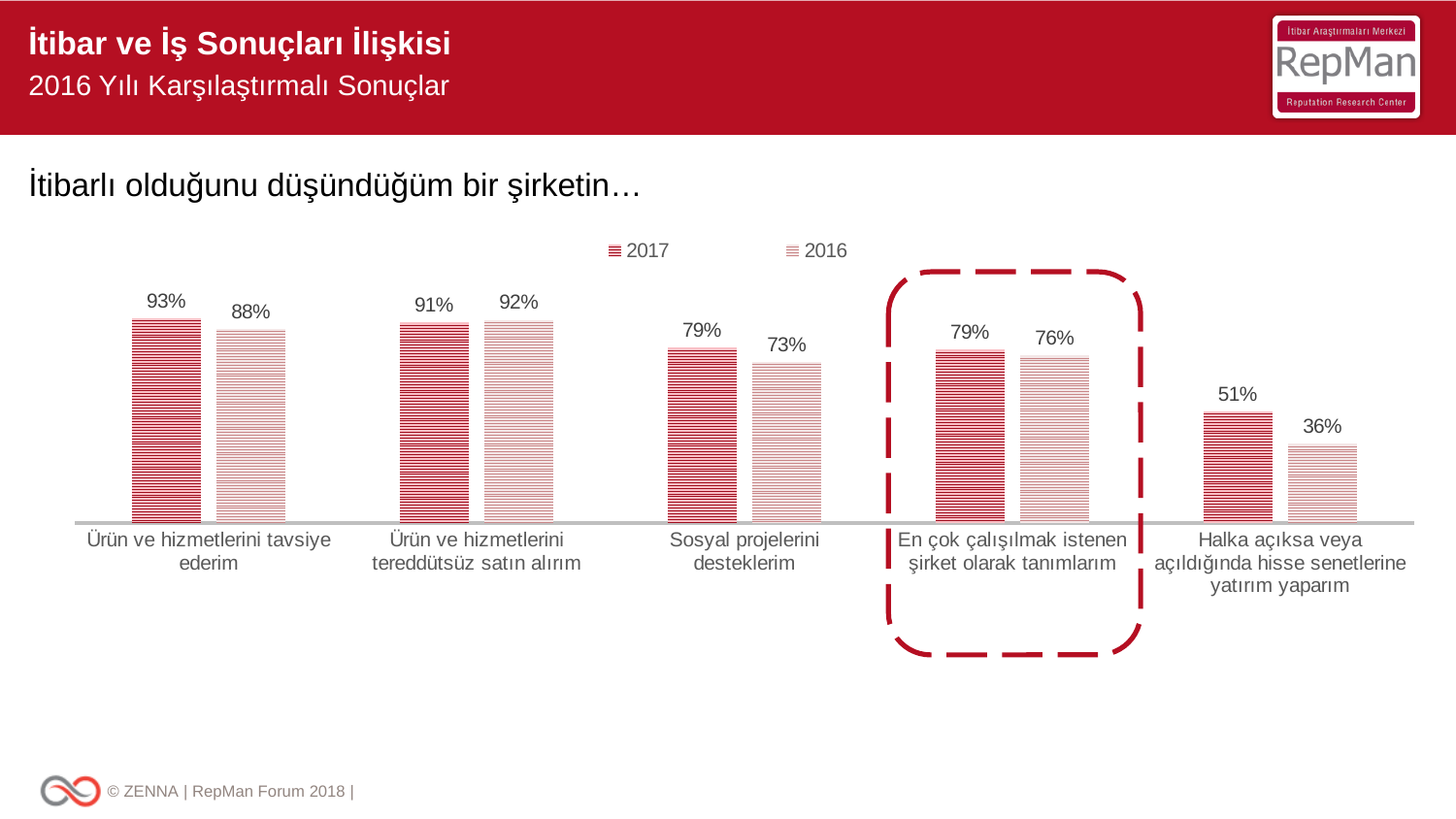
What kind of chart is shown on the slide? Bar chart What is the 2016 value for "Ürün ve hizmetlerini tereddütsüz satın alırım"? 92% How many categories are shown on the x axis? 5 For "Ürün ve hizmetlerini tereddütsüz satın alırım", which year has the larger value, 2017 or 2016? 2016 How many series does the legend list? 2 What is the 2016 value for "Halka açıksa veya açıldığında hisse senetlerine yatırım yaparım"? 36% Which category has the highest 2017 value? Ürün ve hizmetlerini tavsiye ederim What is the 2017 value for "Ürün ve hizmetlerini tavsiye ederim"? 93% Which category has the lowest 2016 value? Halka açıksa veya açıldığında hisse senetlerine yatırım yaparım What is the difference between the 2017 and 2016 values for "Halka açıksa veya açıldığında hisse senetlerine yatırım yaparım"? 15% What is the difference between the 2017 and 2016 values for "Sosyal projelerini desteklerim"? 6% What is the 2017 value for "En çok çalışılmak istenen şirket olarak tanımlarım"? 79%